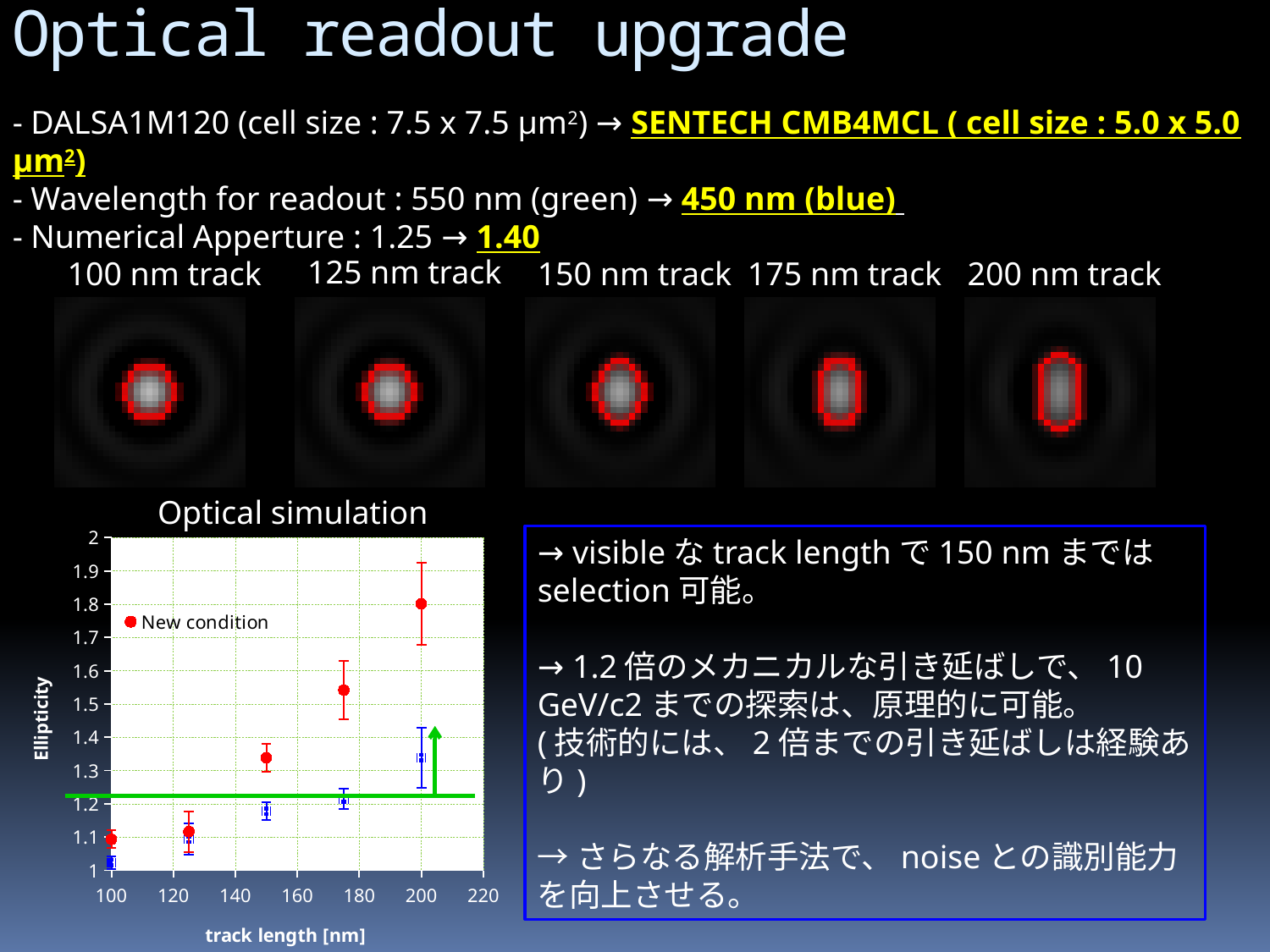
What is the legend entry shown in the Optical simulation chart? New condition In the Optical simulation chart, at which track length is the 'New condition' ellipticity highest? 200 nm In the Optical simulation chart, is the 'New condition' ellipticity at 150 nm greater or less than 1.2? greater What is the title of the chart on the slide? Optical simulation What kind of chart is the Optical simulation chart? scatter plot In the Optical simulation chart, is the 'New condition' ellipticity at 175 nm greater or less than 1.4? greater How many series does the legend of the Optical simulation chart list? 1 In the Optical simulation chart, is the 'New condition' ellipticity at 200 nm greater or less than 1.7? greater In the Optical simulation chart, which has the larger 'New condition' ellipticity: 150 nm or 200 nm track length? 200 nm In the Optical simulation chart, does the 'New condition' ellipticity rise or fall as track length increases from 100 nm to 200 nm? rise How many red 'New condition' data points are plotted in the Optical simulation chart? 5